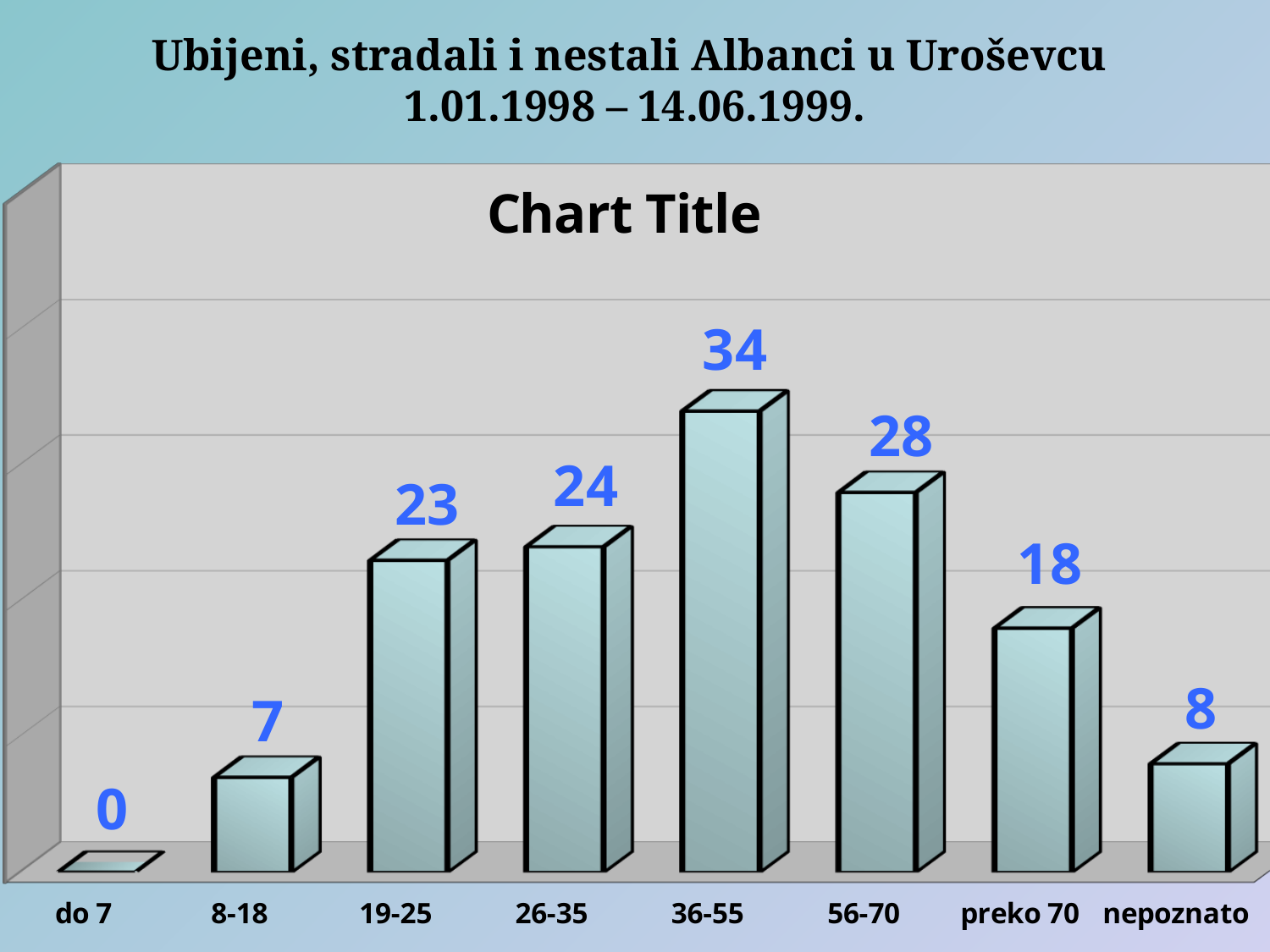
What is the difference between the values for 19-25 and 8-18? 16 Do the values rise or fall from the 36-55 category to the 'preko 70' category? fall Which is larger, the value for 26-35 or the value for 56-70? 56-70 Which age category has the highest value? 36-55 How many categories are shown on the x axis? 8 What is the title printed inside the chart area? Chart Title What kind of chart is shown on the slide? bar chart What is the value for the 36-55 age group? 34 What is the value for the 'preko 70' category? 18 Which category has the lowest value? do 7 What is the value for the 'nepoznato' category? 8 What is the difference between the values for 36-55 and 56-70? 6